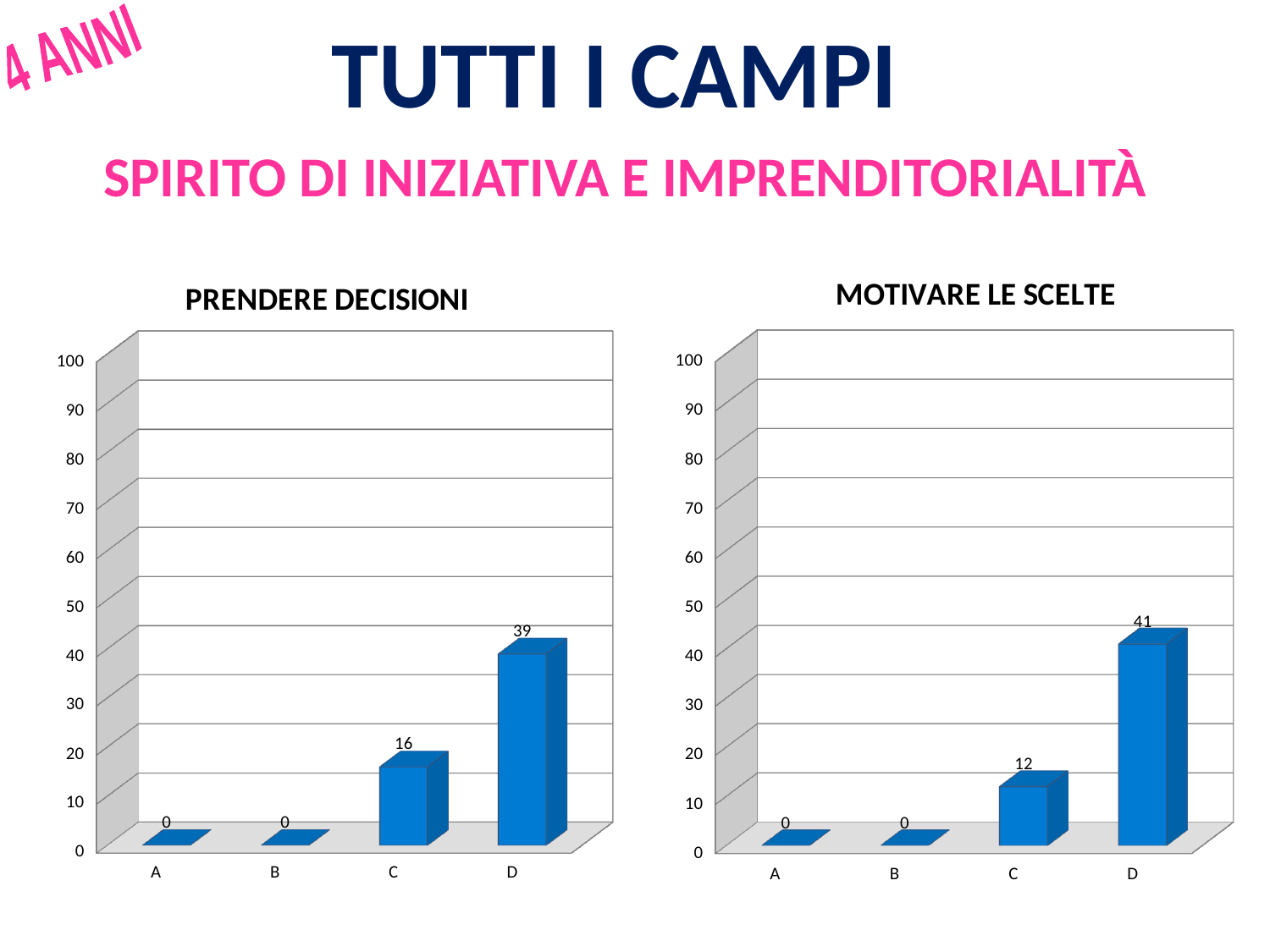
In the MOTIVARE LE SCELTE chart, what is the value for category C? 12 In the PRENDERE DECISIONI chart, what is the value for category D? 39 What kind of chart is the MOTIVARE LE SCELTE chart? Bar chart In the PRENDERE DECISIONI chart, what is the value for category C? 16 In the MOTIVARE LE SCELTE chart, which category has the highest value? D In the PRENDERE DECISIONI chart, what is the difference between the values for D and C? 23 In the MOTIVARE LE SCELTE chart, what is the value for category A? 0 In the MOTIVARE LE SCELTE chart, what is the value for category D? 41 In the PRENDERE DECISIONI chart, which category has the highest value? D Which is larger: the value for D in the PRENDERE DECISIONI chart or the value for D in the MOTIVARE LE SCELTE chart? D in MOTIVARE LE SCELTE In the MOTIVARE LE SCELTE chart, what is the difference between the values for D and C? 29 How many categories are shown on the x axis of the PRENDERE DECISIONI chart? 4